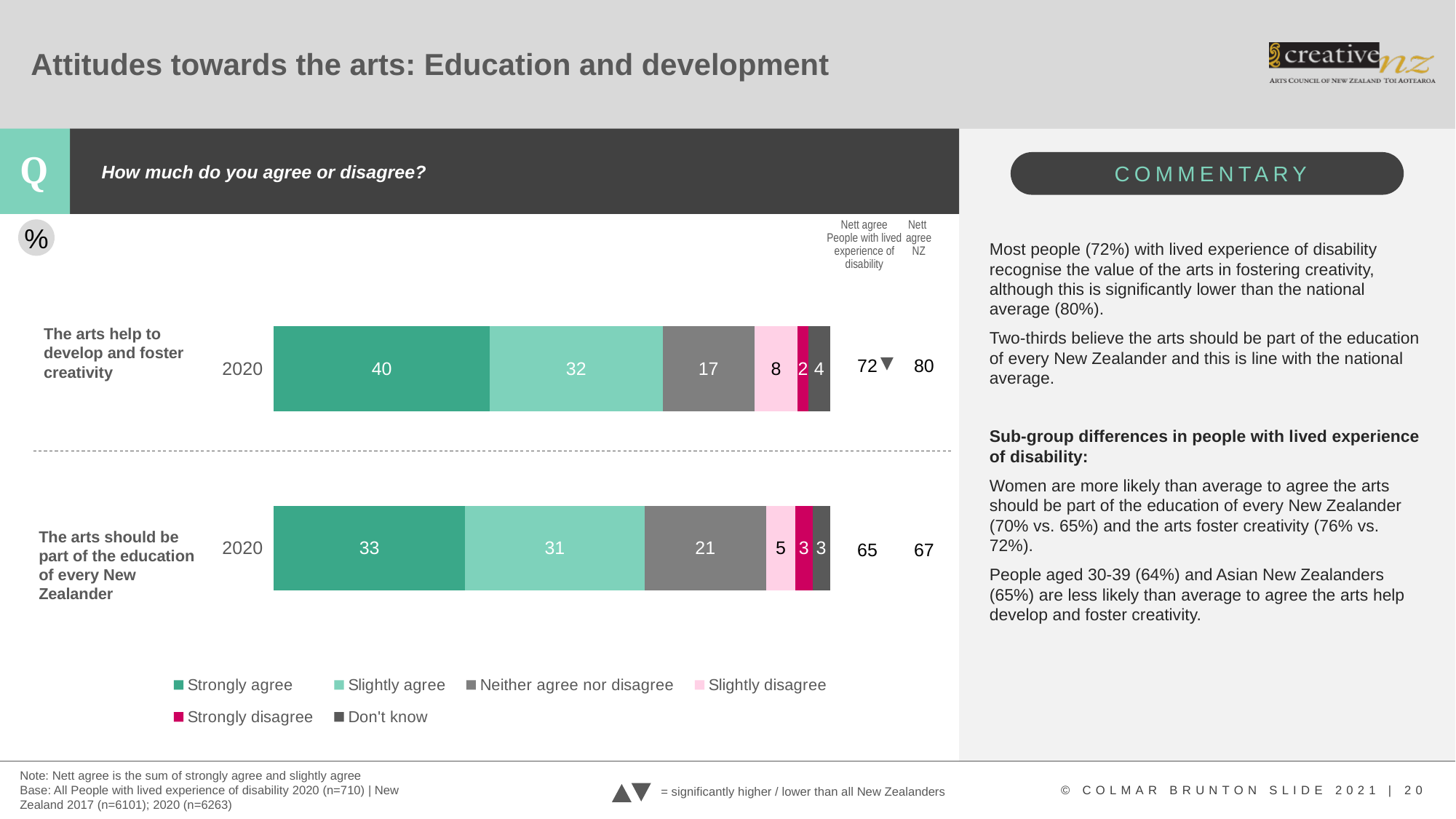
What type of chart is shown on the slide? Stacked bar chart What percentage slightly agree that the arts should be part of the education of every New Zealander? 31 Which statement has a higher 'Neither agree nor disagree' value? The arts should be part of the education of every New Zealander How many response categories does the legend list? 6 What percentage strongly agree that the arts help to develop and foster creativity? 40 Which response category has the lowest value for 'The arts help to develop and foster creativity'? Strongly disagree What is the difference between the Nett agree for people with lived experience of disability and the Nett agree NZ for 'The arts help to develop and foster creativity'? 8 What percentage neither agree nor disagree that the arts should be part of the education of every New Zealander? 21 What is the difference between the strongly agree values for the two statements? 7 Which response category has the highest value for 'The arts help to develop and foster creativity'? Strongly agree What is the Nett agree NZ value for 'The arts should be part of the education of every New Zealander'? 67 What is the Nett agree value for people with lived experience of disability for 'The arts help to develop and foster creativity'? 72